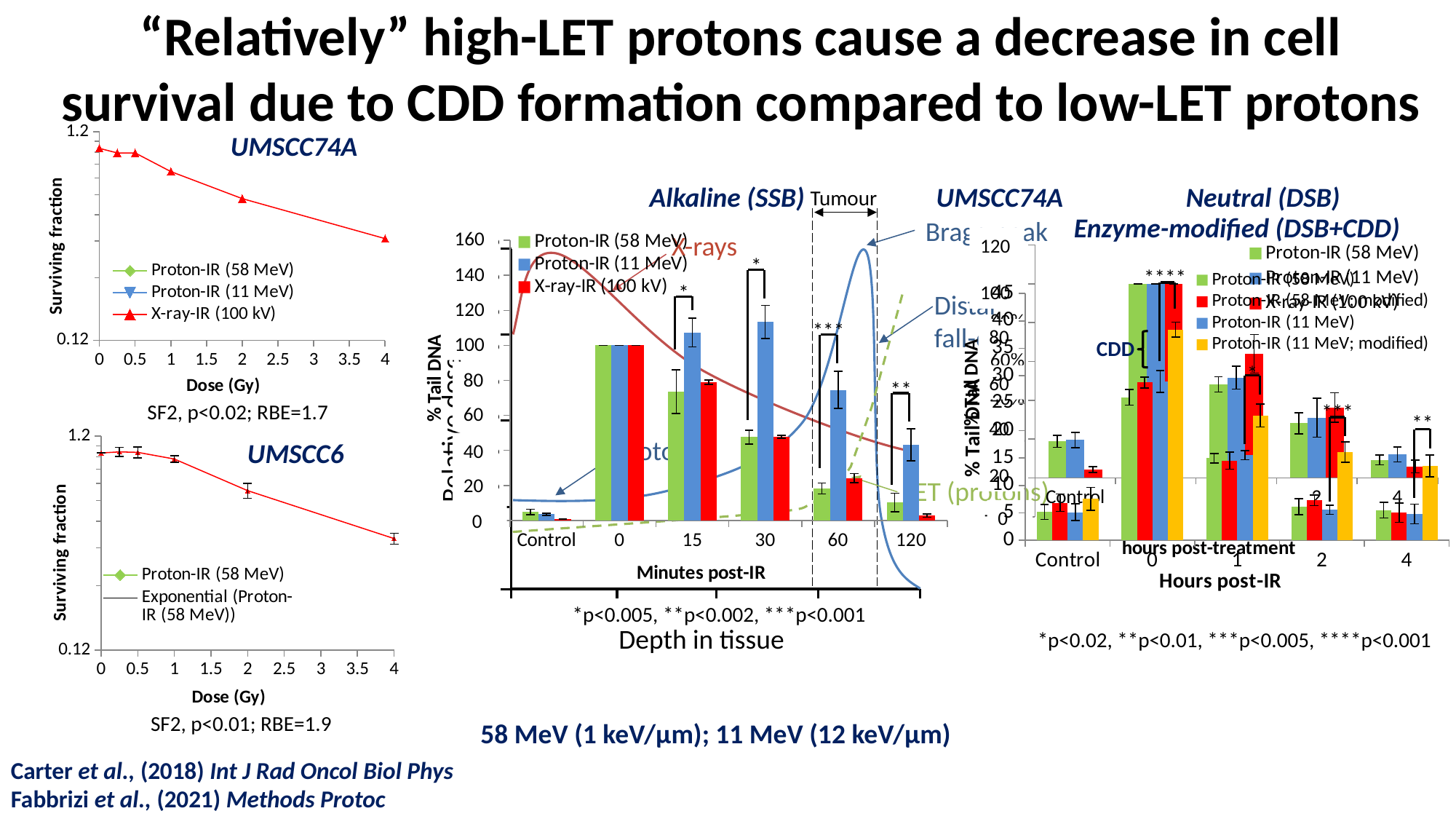
How many entries does the legend of the UMSCC6 surviving fraction chart at the bottom left list? 2 In the Alkaline (SSB) chart, is the value for Proton-IR (58 MeV) at 30 minutes post-IR greater or less than 60? less In the Alkaline (SSB) chart, is the value for X-ray-IR (100 kV) at 120 minutes post-IR greater or less than 20? less In the UMSCC74A surviving fraction chart at the top left, does the X-ray-IR (100 kV) line rise or fall as dose increases? fall What kind of chart is the Alkaline (SSB) chart in the middle of the slide? bar chart How many categories are shown on the x axis of the Alkaline (SSB) chart? 6 In the Alkaline (SSB) chart, does the Proton-IR (58 MeV) series rise or fall from 0 to 120 minutes post-IR? fall In the Alkaline (SSB) chart, is the value for Proton-IR (11 MeV) at 30 minutes post-IR greater or less than 100? greater How many series does the legend of the Alkaline (SSB) chart list? 3 What is the x-axis label of the Alkaline (SSB) chart? Minutes post-IR In the Alkaline (SSB) chart, which series has the highest value at 30 minutes post-IR? Proton-IR (11 MeV) In the Alkaline (SSB) chart, at 60 minutes post-IR, which is larger: Proton-IR (11 MeV) or Proton-IR (58 MeV)? Proton-IR (11 MeV)